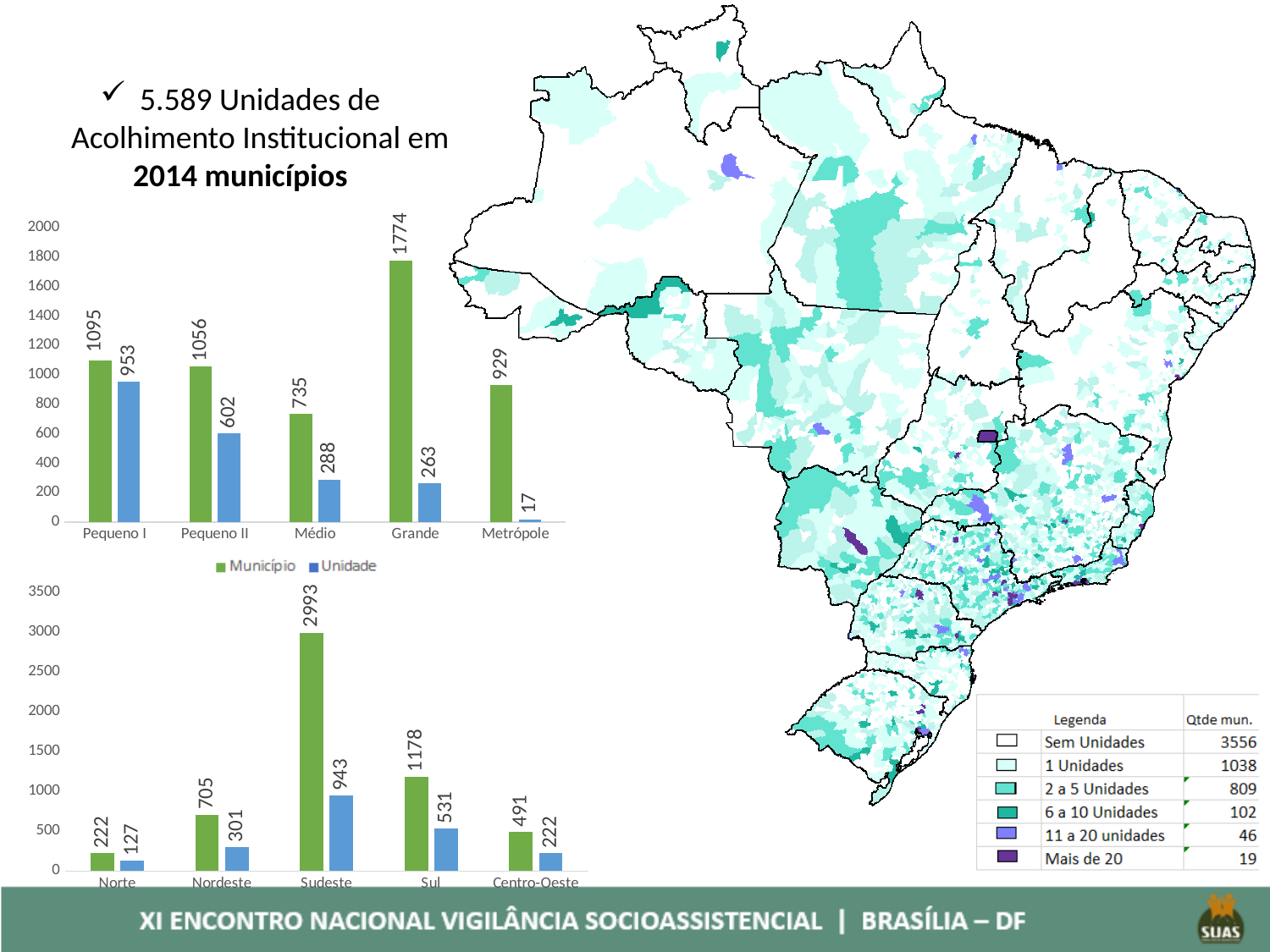
In the top bar chart (by municipality size), which category has the lowest Município value? Médio In the top bar chart (by municipality size), what is the difference between the Município and Unidade values for Pequeno II? 454 In the bottom bar chart (by region), what is the Município value for Sudeste? 2993 What type of chart is the bottom chart (by region)? Bar chart In the top bar chart (by municipality size), which category has the highest Unidade value? Pequeno I In the bottom bar chart (by region), how many regions are shown on the x axis? 5 In the bottom bar chart (by region), which region has the lowest Unidade value? Norte In the bottom bar chart (by region), what is the Unidade value for Sul? 531 In the top bar chart (by municipality size), what is the Unidade value for Metrópole? 17 In the top bar chart (by municipality size), what is the Município value for Grande? 1774 In the bottom bar chart (by region), which is larger: the Unidade value for Nordeste or the Unidade value for Centro-Oeste? Nordeste In the top bar chart (by municipality size), how many series does the legend list? 2